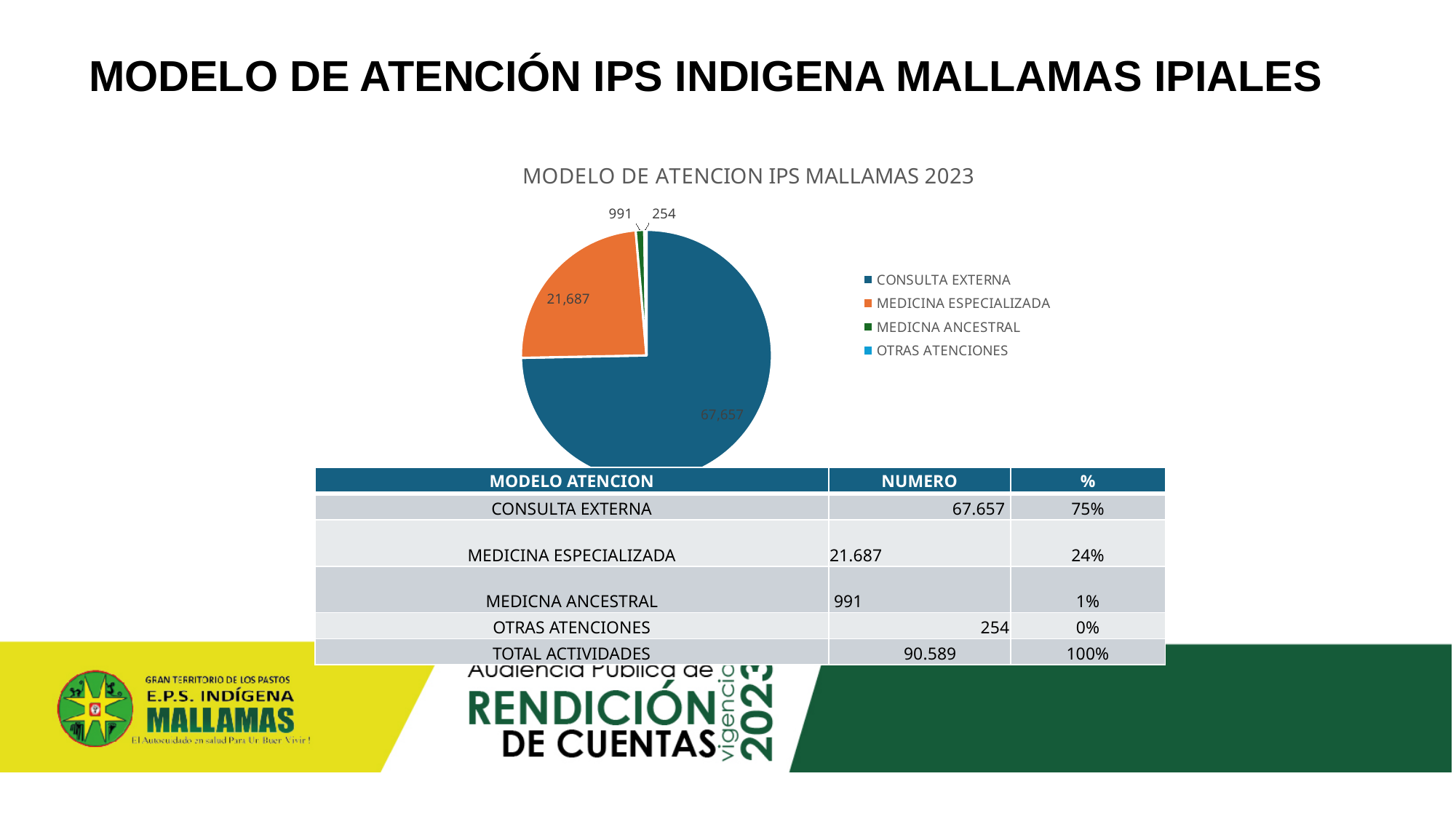
What type of chart is shown on the slide? pie chart Which is larger, MEDICNA ANCESTRAL or OTRAS ATENCIONES? MEDICNA ANCESTRAL What is the value for MEDICINA ESPECIALIZADA? 21,687 What share of the pie does CONSULTA EXTERNA represent? 75% Which category has the smallest slice? OTRAS ATENCIONES What is the value for OTRAS ATENCIONES? 254 How many series does the legend list? 4 What is the value for MEDICNA ANCESTRAL? 991 What is the title of the chart? MODELO DE ATENCION IPS MALLAMAS 2023 What is the value for CONSULTA EXTERNA? 67,657 What is the difference between CONSULTA EXTERNA and MEDICINA ESPECIALIZADA? 45,970 Which category has the largest slice? CONSULTA EXTERNA